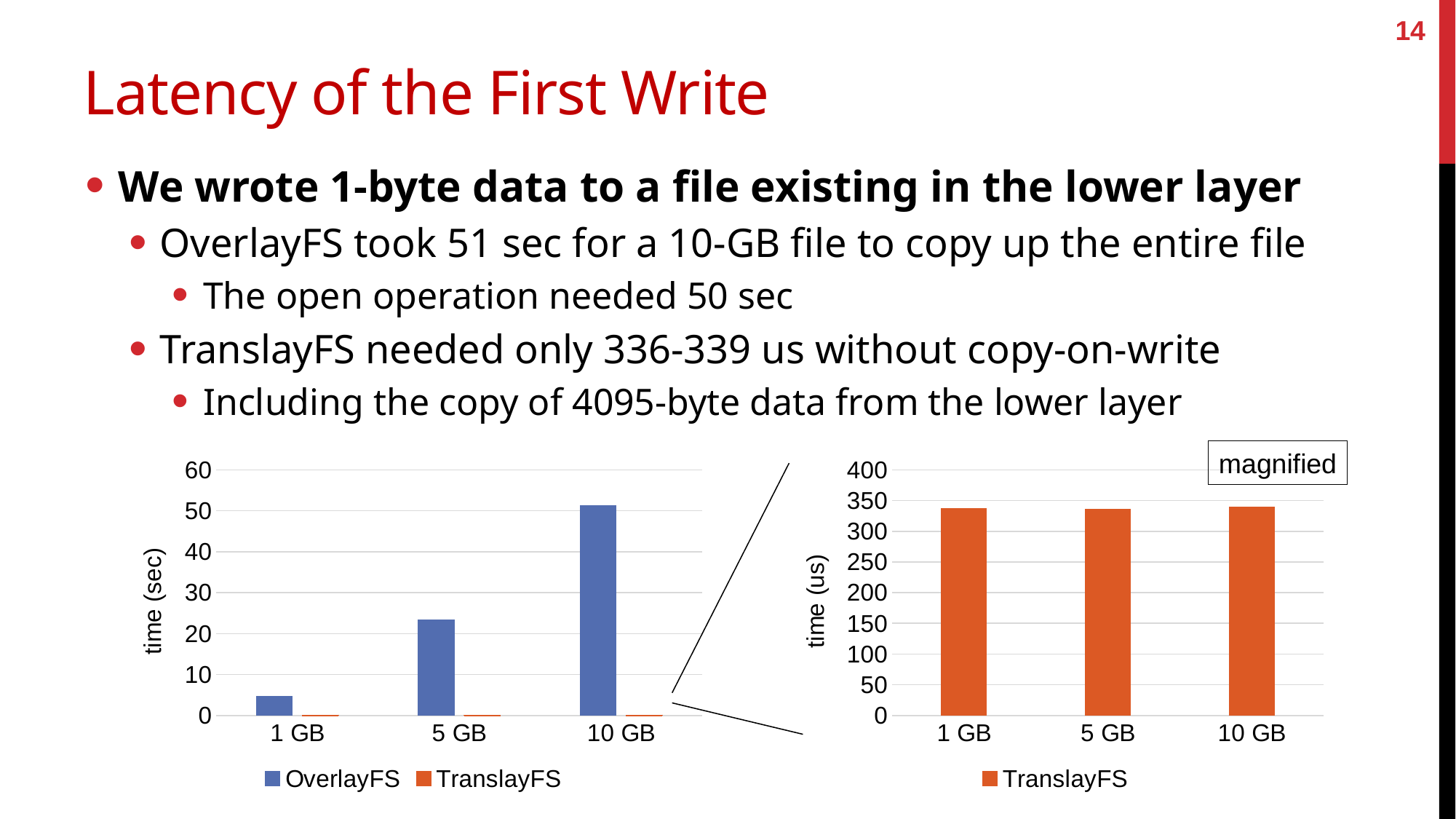
In the left chart, which is larger at 10 GB: OverlayFS or TranslayFS? OverlayFS How many series does the legend of the left chart list? 2 In the right (magnified) chart, is the TranslayFS value for 5 GB greater or less than 300? greater What kind of chart is the left chart (time in sec)? bar chart In the left chart, which file size has the highest OverlayFS time? 10 GB In the left chart, does the OverlayFS time rise or fall as the file size increases from 1 GB to 10 GB? rise In the left chart, is the OverlayFS value for 10 GB greater or less than 40? greater In the left chart, which file size has the lowest OverlayFS time? 1 GB What is the y-axis label of the right (magnified) chart? time (us) In the left chart, is the OverlayFS value for 1 GB greater or less than 10? less How many file-size categories are shown on the x axis of the left chart? 3